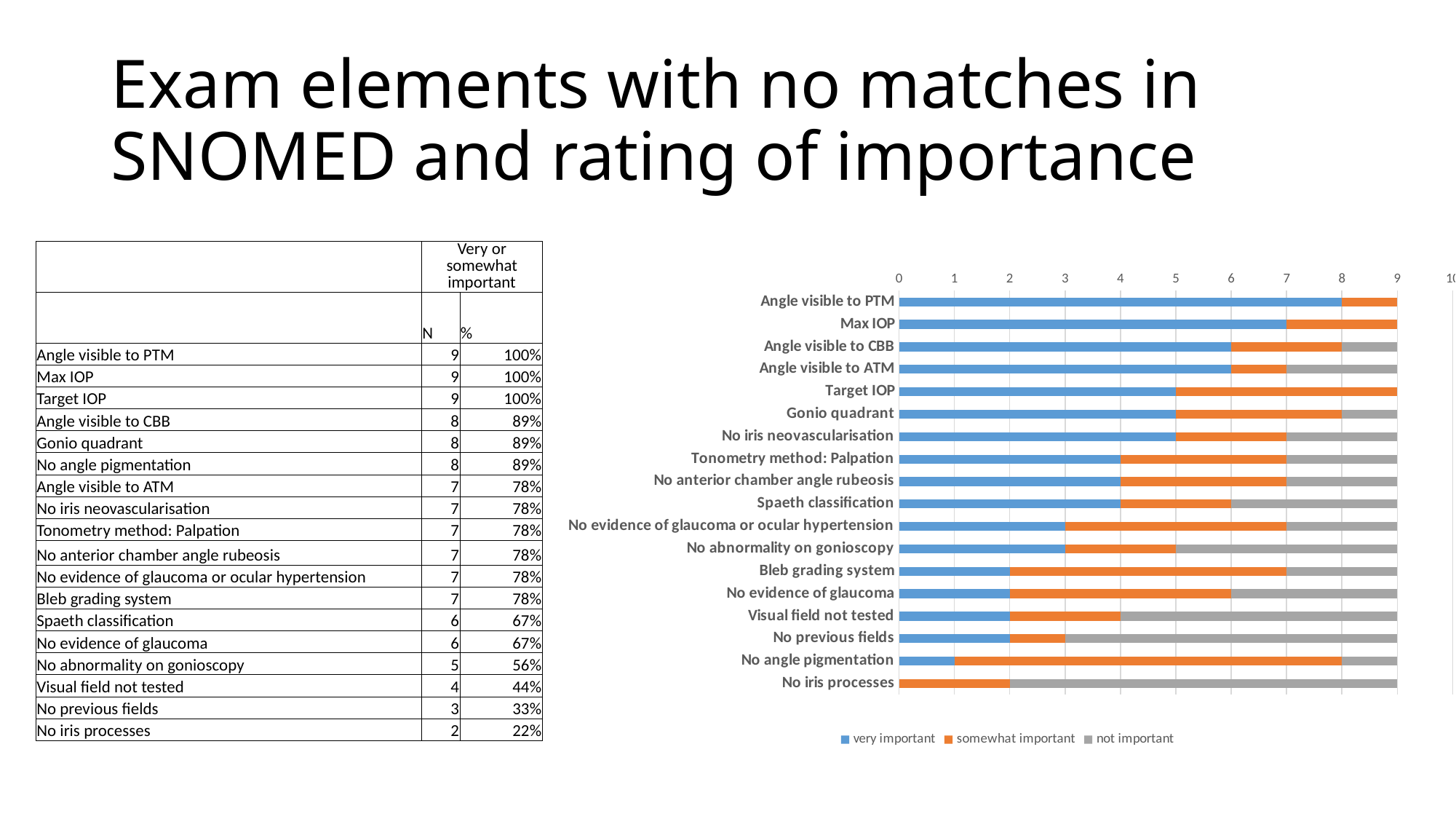
In the chart, which has the larger 'very important' value: Gonio quadrant or Bleb grading system? Gonio quadrant What kind of chart is shown on the right of the slide? stacked bar chart Which exam element has no 'very important' segment at all in the chart? No iris processes How many series does the chart's legend list? 3 How many exam elements (categories) are plotted in the chart? 18 In the chart, what is the difference between the 'very important' values for Angle visible to PTM and No previous fields? 6 In the chart, what is the 'very important' value for Max IOP? 7 In the chart, what is the total length of the stacked bar for Target IOP? 9 Which colour represents 'not important' in the chart's legend? grey In the chart, what is the 'very important' value for Angle visible to CBB? 6 In the chart, is the 'very important' value for No angle pigmentation greater or less than 2? less Which exam element has the longest 'very important' segment in the chart? Angle visible to PTM